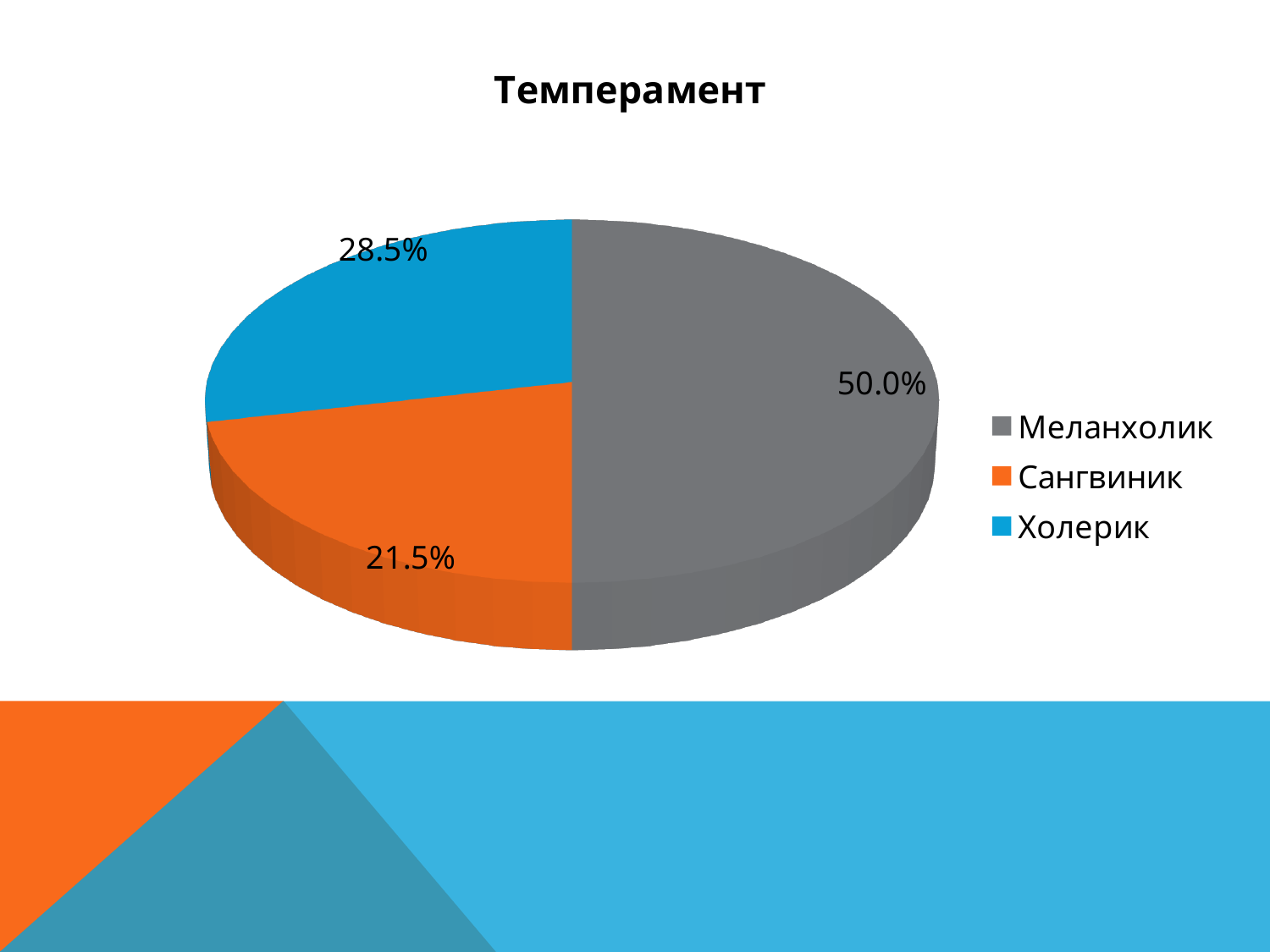
Which is larger, the share of Холерик or the share of Сангвиник? Холерик What is the difference between the shares of Меланхолик and Холерик? 21.5% What colour is the slice for Сангвиник? orange What kind of chart is shown on the slide? pie chart What is the difference between the shares of Холерик and Сангвиник? 7.0% How many categories does the pie chart show? 3 What share of the pie does Меланхолик have? 50.0% What share of the pie does Сангвиник have? 21.5% Which category has the largest slice of the pie? Меланхолик What share of the pie does Холерик have? 28.5% Which category has the smallest slice of the pie? Сангвиник What is the title of the chart? Темперамент